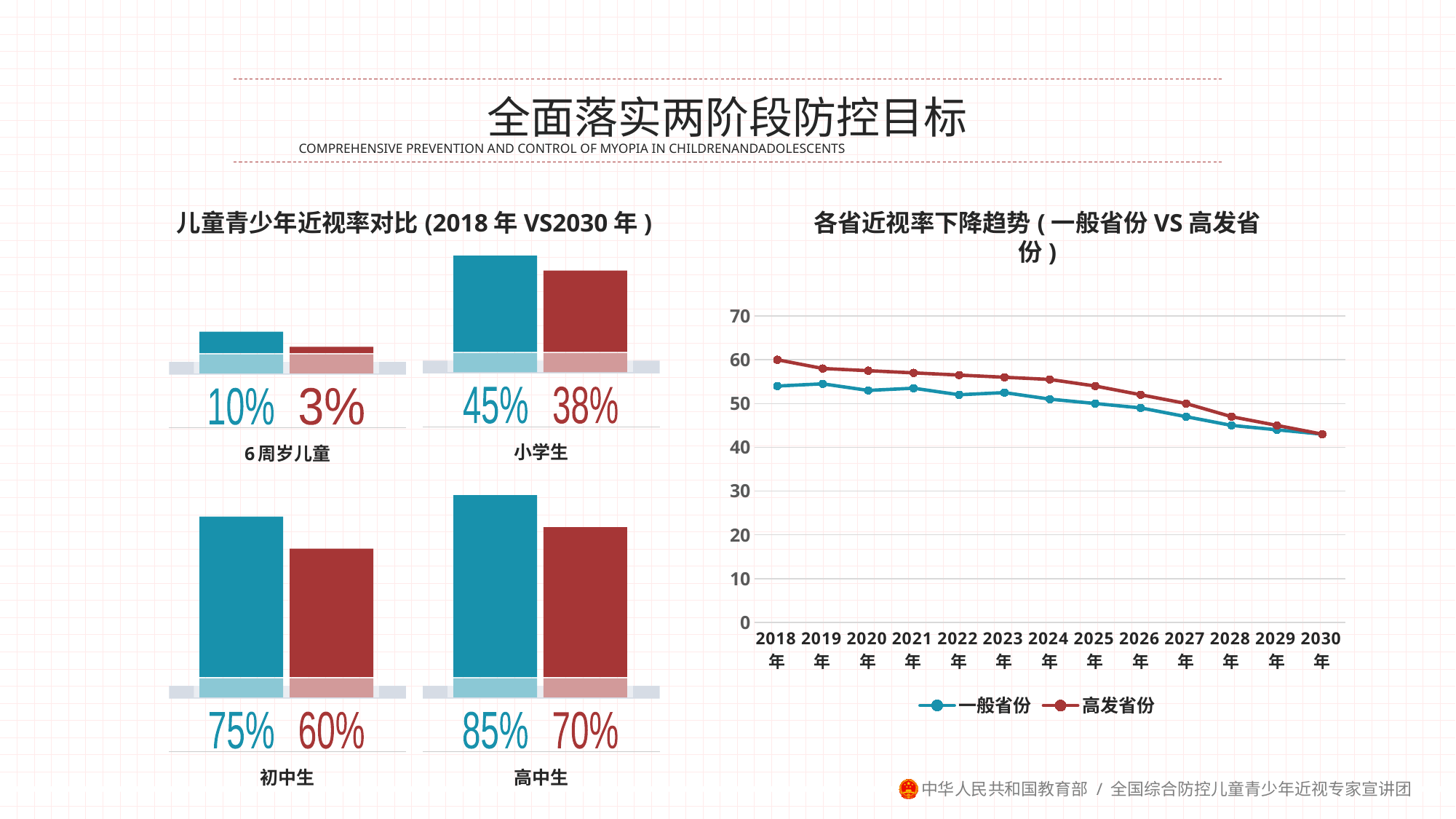
In the bar chart 儿童青少年近视率对比, what is the difference between the 2018 and 2030 values for 初中生? 15% In the line chart 各省近视率下降趋势, how many series does the legend list? 2 In the line chart 各省近视率下降趋势, is the value for 高发省份 in 2018 greater or less than 50? greater In the line chart 各省近视率下降趋势, do the values rise or fall from 2018 to 2030? fall In the bar chart 儿童青少年近视率对比, what is the 2018 value for 高中生? 85% In the line chart 各省近视率下降趋势, how many years are shown on the x axis? 13 In the bar chart 儿童青少年近视率对比, which group has the highest 2018 value? 高中生 In the bar chart 儿童青少年近视率对比, how many groups are shown? 4 In the bar chart 儿童青少年近视率对比, what is the 2030 value for 小学生? 38% In the bar chart 儿童青少年近视率对比, what is the 2030 value for 6周岁儿童? 3% In the line chart 各省近视率下降趋势, is the value for 一般省份 in 2030 greater or less than 50? less In the bar chart 儿童青少年近视率对比, which group has the lowest 2030 value? 6周岁儿童